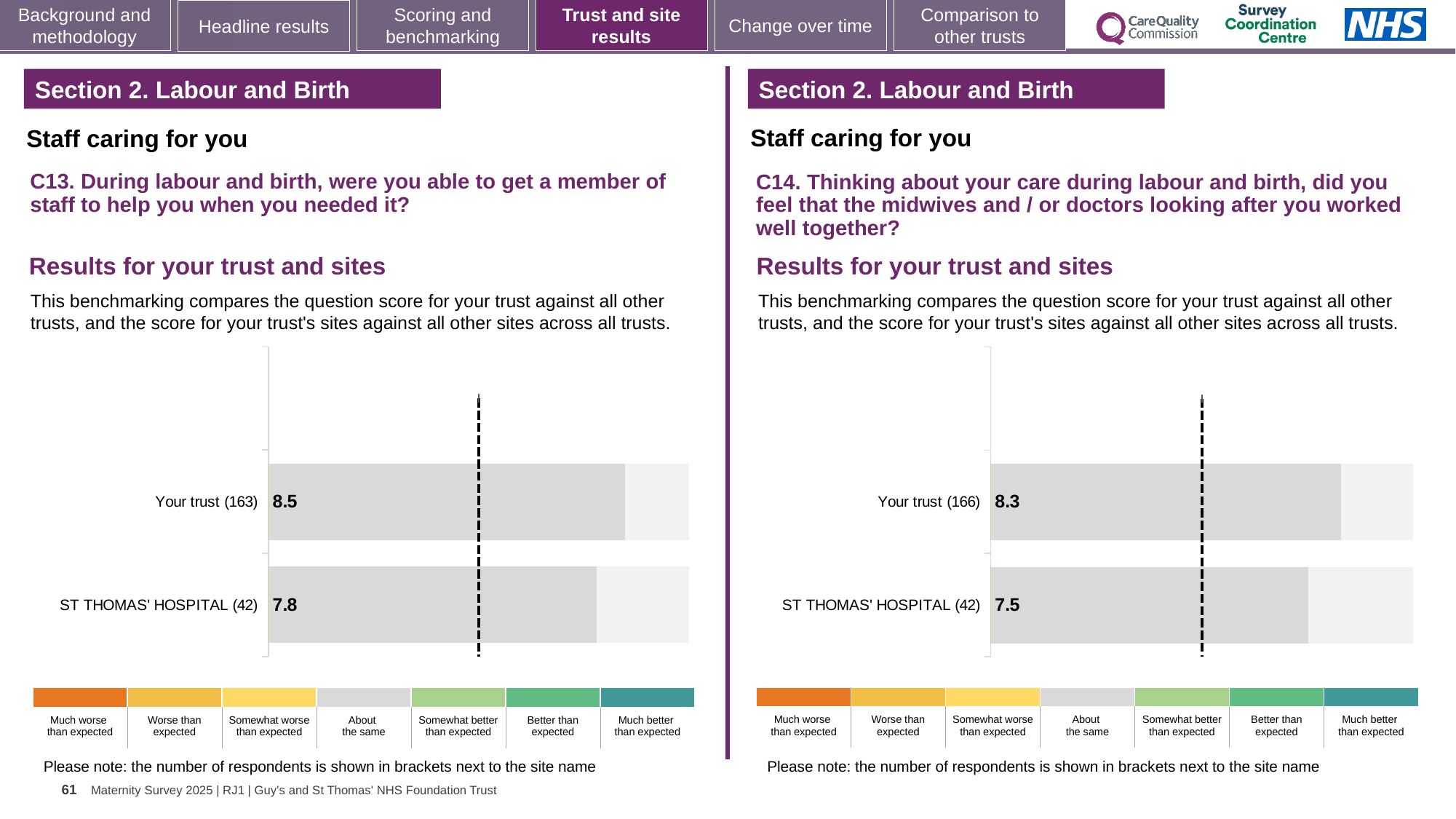
What type of chart is used in the C14 chart on the right? Bar chart How many respondents are shown in brackets for Your trust in the C14 chart on the right? 166 In the C13 chart on the left, which row has the higher score? Your trust (163) In the C14 chart on the right, what is the score for Your trust (166)? 8.3 How many bars are plotted in the C13 chart on the left? 2 In the C14 chart on the right, what is the difference between the Your trust score and the ST THOMAS' HOSPITAL score? 0.8 Is the Your trust score higher in the C13 chart on the left or in the C14 chart on the right? C13 chart on the left In the C13 chart on the left, what is the score for Your trust (163)? 8.5 In the C13 chart on the left, what is the difference between the Your trust score and the ST THOMAS' HOSPITAL score? 0.7 In the C14 chart on the right, what is the score for ST THOMAS' HOSPITAL (42)? 7.5 In the C14 chart on the right, which row has the lowest score? ST THOMAS' HOSPITAL (42) In the C13 chart on the left, what is the score for ST THOMAS' HOSPITAL (42)? 7.8